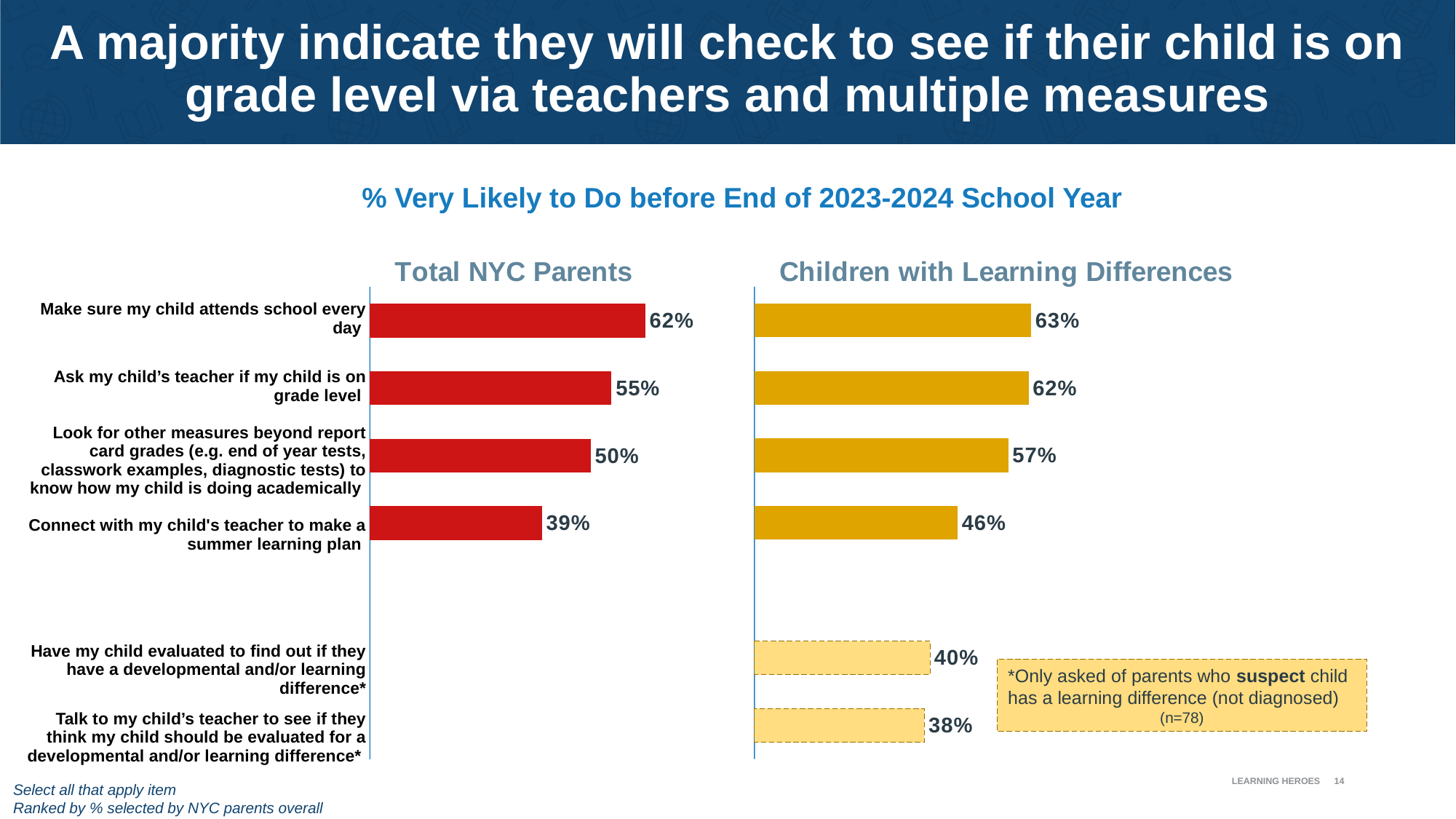
For looking for other measures beyond report card grades, which group has the higher percentage: Total NYC Parents or Children with Learning Differences? Children with Learning Differences How many bars are shown in the Total NYC Parents chart? 4 In the Children with Learning Differences chart, what percentage are very likely to have their child evaluated to find out if they have a developmental and/or learning difference? 40% What is the subtitle shown above the two charts? % Very Likely to Do before End of 2023-2024 School Year In the Total NYC Parents chart, what percentage are very likely to make sure their child attends school every day? 62% In the Children with Learning Differences chart, what percentage are very likely to ask their child's teacher if their child is on grade level? 62% What type of chart is used on this slide? Bar chart What is the difference between the Children with Learning Differences value and the Total NYC Parents value for connecting with the child's teacher to make a summer learning plan? 7 percentage points In the Children with Learning Differences chart, what is the difference between the value for making sure the child attends school every day and the value for talking to the teacher about evaluation? 25 percentage points In the Children with Learning Differences chart, which item has the highest percentage? Make sure my child attends school every day In the Total NYC Parents chart, which item has the lowest percentage? Connect with my child's teacher to make a summer learning plan How many bars are shown in the Children with Learning Differences chart? 6